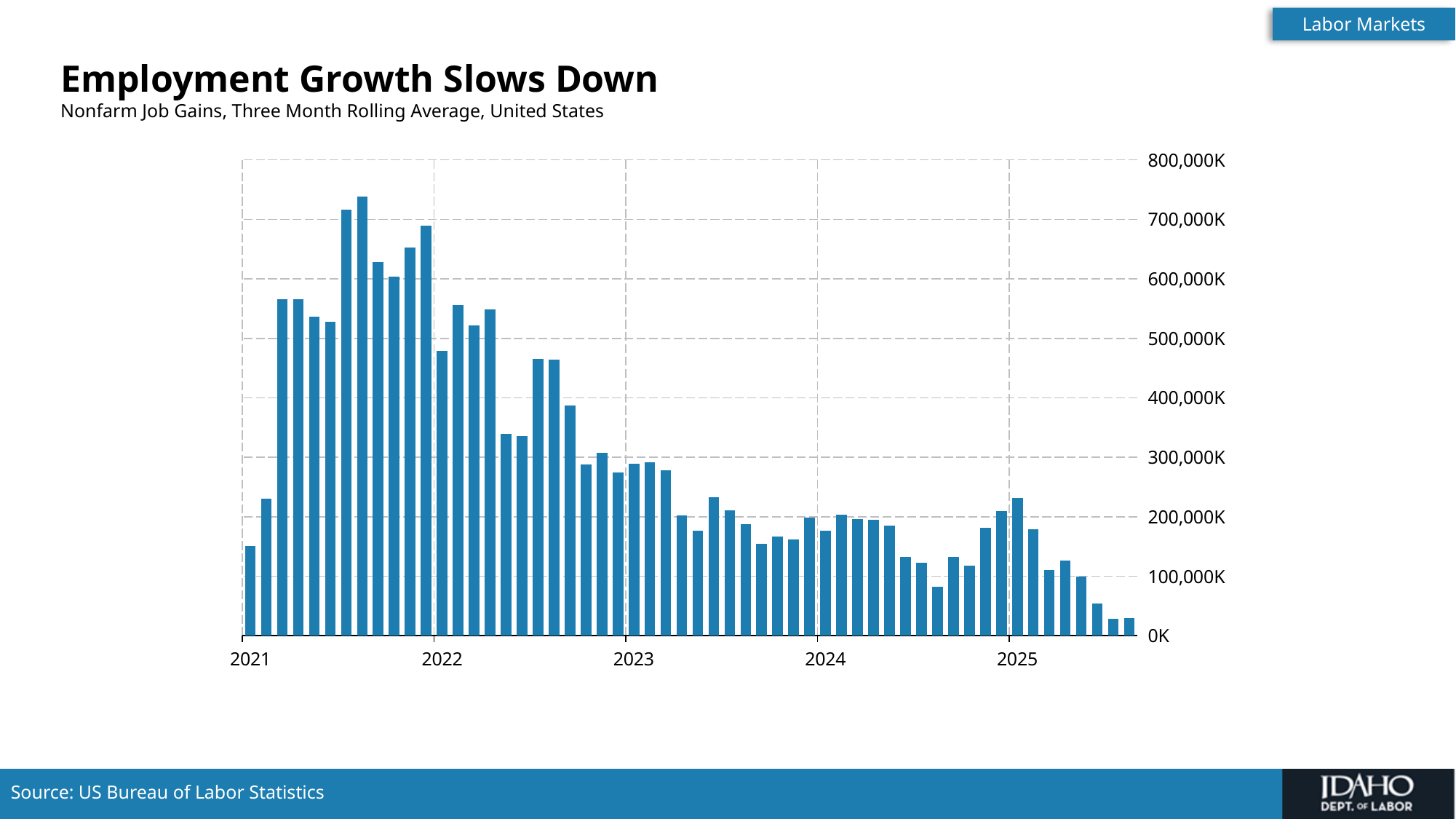
Overall, do the values rise or fall from 2021 to 2025 along the x axis? fall What is the title of the chart on the slide? Employment Growth Slows Down Is the value of the first bar at the 2021 tick greater or less than 200,000K? less Is the value of the bar at the 2022 tick greater or less than 500,000K? less Which is larger, the tallest bar in 2021 or the tallest bar in 2025? the tallest bar in 2021 What kind of chart is shown on the slide? bar chart In which year do the shortest bars on the chart occur? 2025 Is the value of the tallest bar greater or less than 700,000K? greater In which year does the tallest bar on the chart occur? 2021 Which is larger, the bar at the 2022 tick or the bar at the 2023 tick? the bar at the 2022 tick What is the source cited for the chart? US Bureau of Labor Statistics